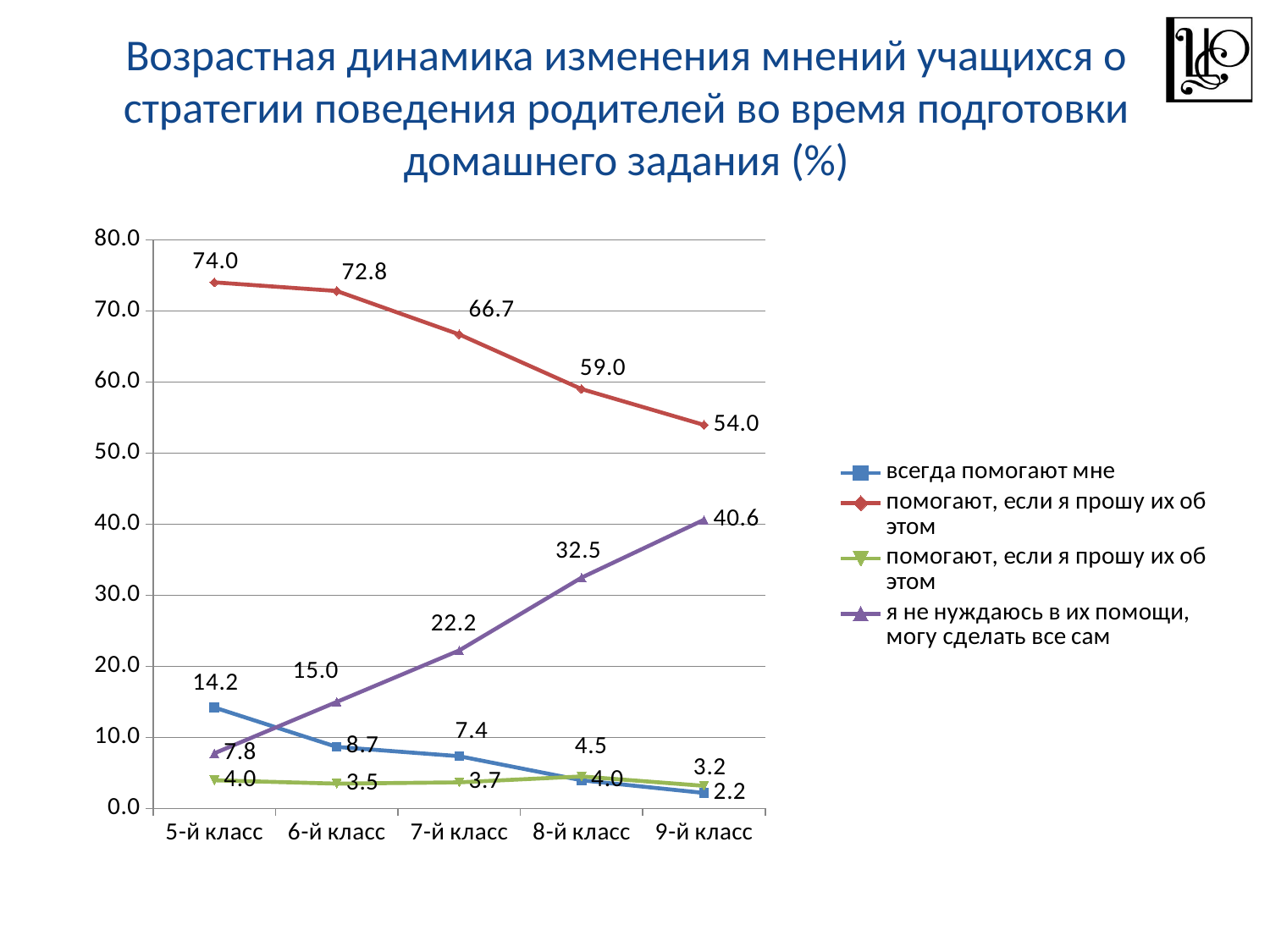
Does the value for "я не нуждаюсь в их помощи, могу сделать все сам" rise or fall from 5-й класс to 9-й класс? rise Which is larger in 8-й класс: "всегда помогают мне" or "я не нуждаюсь в их помощи, могу сделать все сам"? я не нуждаюсь в их помощи, могу сделать все сам How many grade categories are shown on the x axis? 5 In which grade is the red line (помогают, если я прошу их об этом) highest? 5-й класс In which grade is the value for "я не нуждаюсь в их помощи, могу сделать все сам" lowest? 5-й класс What is the difference between the red line's values in 5-й класс and 9-й класс? 20.0 What type of chart is shown on the slide? line chart What is the value of the red line (помогают, если я прошу их об этом) in 7-й класс? 66.7 What is the value for "всегда помогают мне" in 5-й класс? 14.2 How many series does the legend list? 4 Does the value for "всегда помогают мне" rise or fall from 5-й класс to 9-й класс? fall What is the value for "я не нуждаюсь в их помощи, могу сделать все сам" in 9-й класс? 40.6